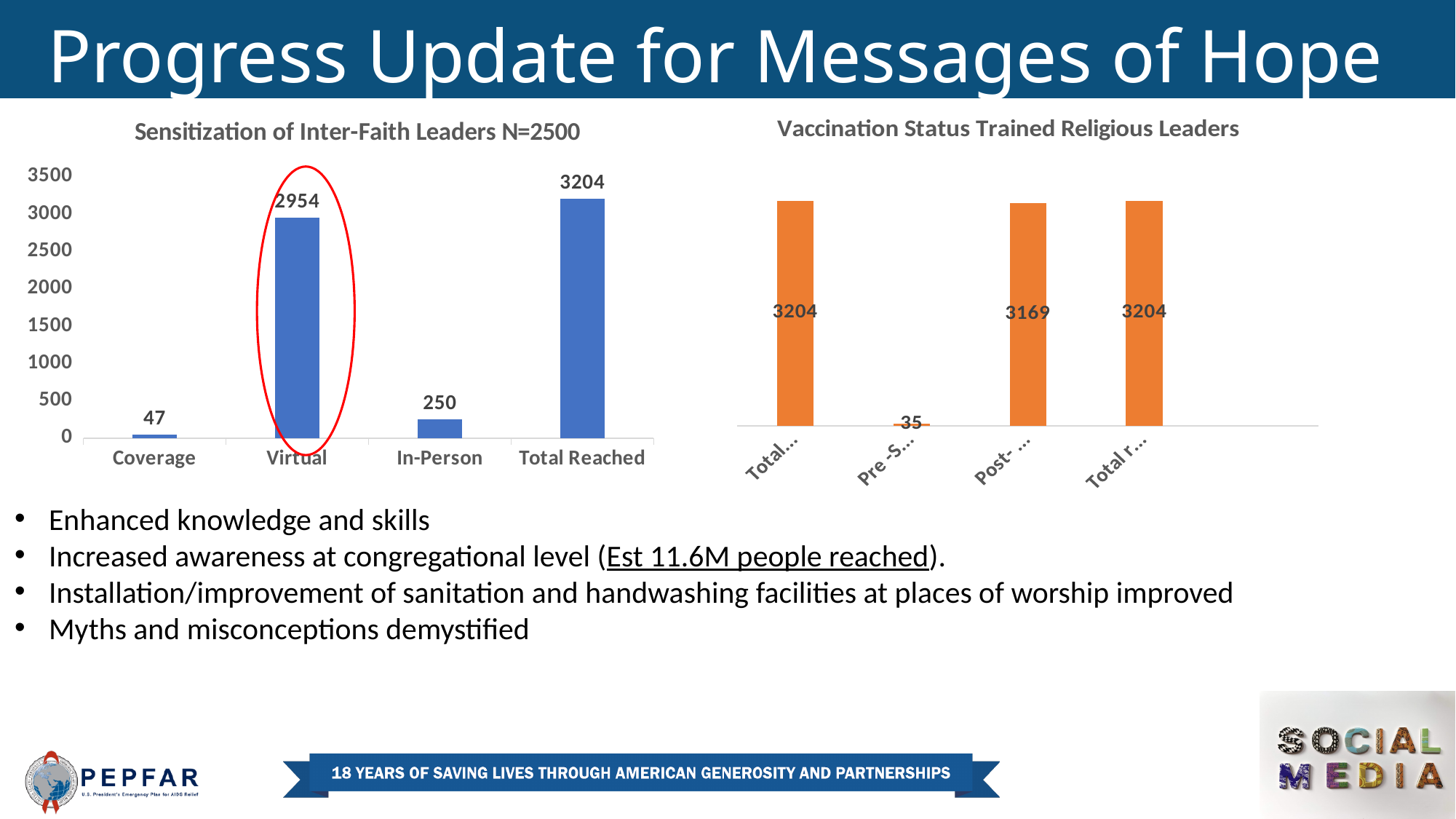
What kind of chart is the 'Vaccination Status Trained Religious Leaders' chart? Bar chart In the 'Sensitization of Inter-Faith Leaders N=2500' chart, what is the value for In-Person? 250 How many categories are shown in the 'Sensitization of Inter-Faith Leaders N=2500' chart? 4 In the 'Sensitization of Inter-Faith Leaders N=2500' chart, what is the value for Coverage? 47 In the 'Sensitization of Inter-Faith Leaders N=2500' chart, which category has the lowest value? Coverage In the 'Sensitization of Inter-Faith Leaders N=2500' chart, what is the difference between Virtual and In-Person? 2704 In the 'Vaccination Status Trained Religious Leaders' chart, what is the value of the second bar from the left? 35 In the 'Sensitization of Inter-Faith Leaders N=2500' chart, what is the value for Virtual? 2954 In the 'Vaccination Status Trained Religious Leaders' chart, what is the value of the third bar from the left? 3169 In the 'Sensitization of Inter-Faith Leaders N=2500' chart, which category has the highest value? Total Reached In the 'Sensitization of Inter-Faith Leaders N=2500' chart, which is larger, In-Person or Coverage? In-Person In the 'Sensitization of Inter-Faith Leaders N=2500' chart, which category is circled in red? Virtual